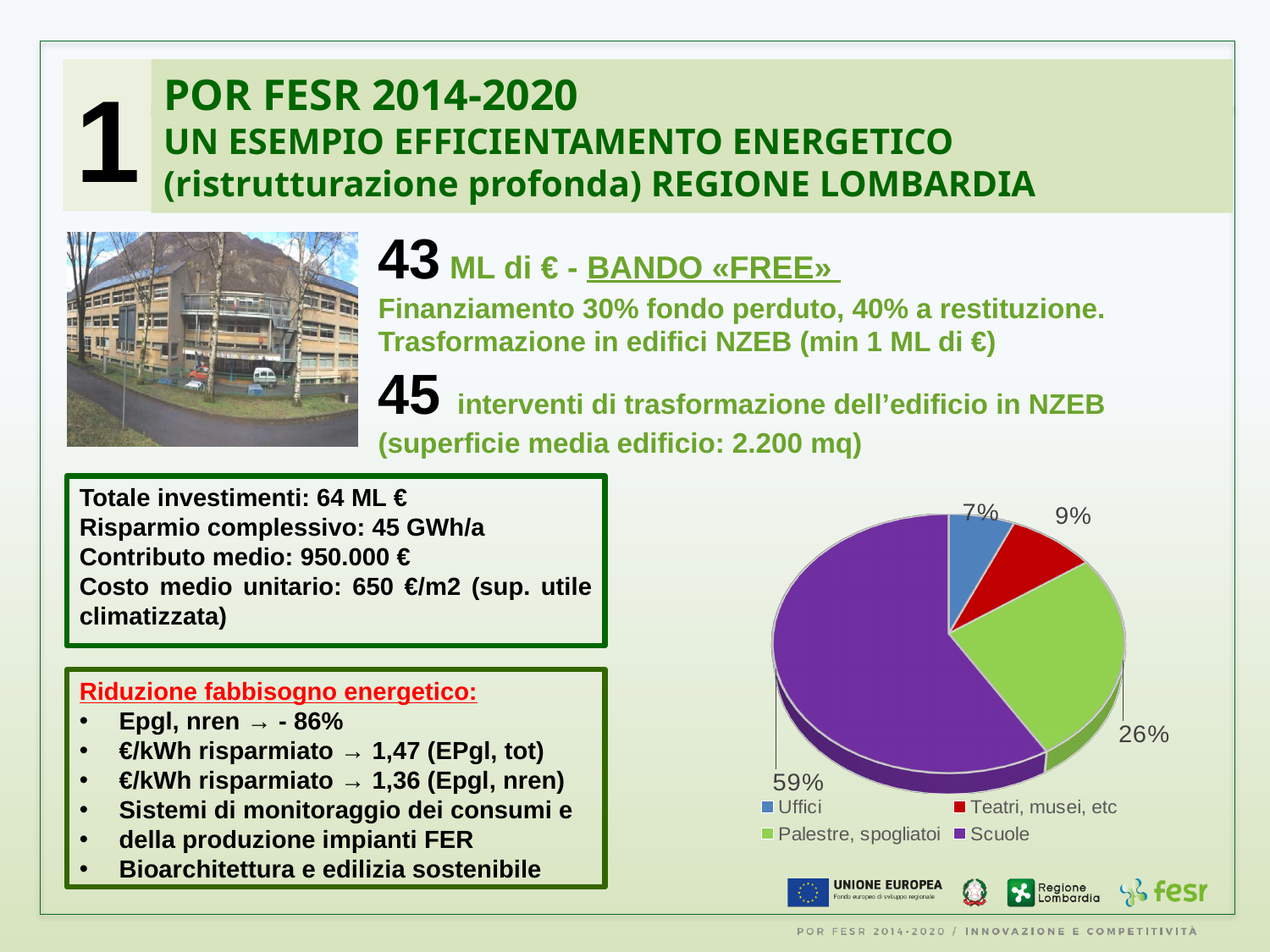
Which slice is larger in the pie chart, Teatri, musei, etc or Uffici? Teatri, musei, etc What share of the pie chart does Scuole represent? 59% How many categories does the pie chart show? 4 What colour is the Scuole slice in the pie chart? purple What share of the pie chart does Uffici represent? 7% What share of the pie chart does Palestre, spogliatoi represent? 26% Which category is shown in green in the pie chart legend? Palestre, spogliatoi What is the difference in percentage points between the Scuole slice and the Palestre, spogliatoi slice? 33 What kind of chart is shown on the slide? pie chart Which category has the largest slice in the pie chart? Scuole What share of the pie chart does Teatri, musei, etc represent? 9% Which category has the smallest slice in the pie chart? Uffici